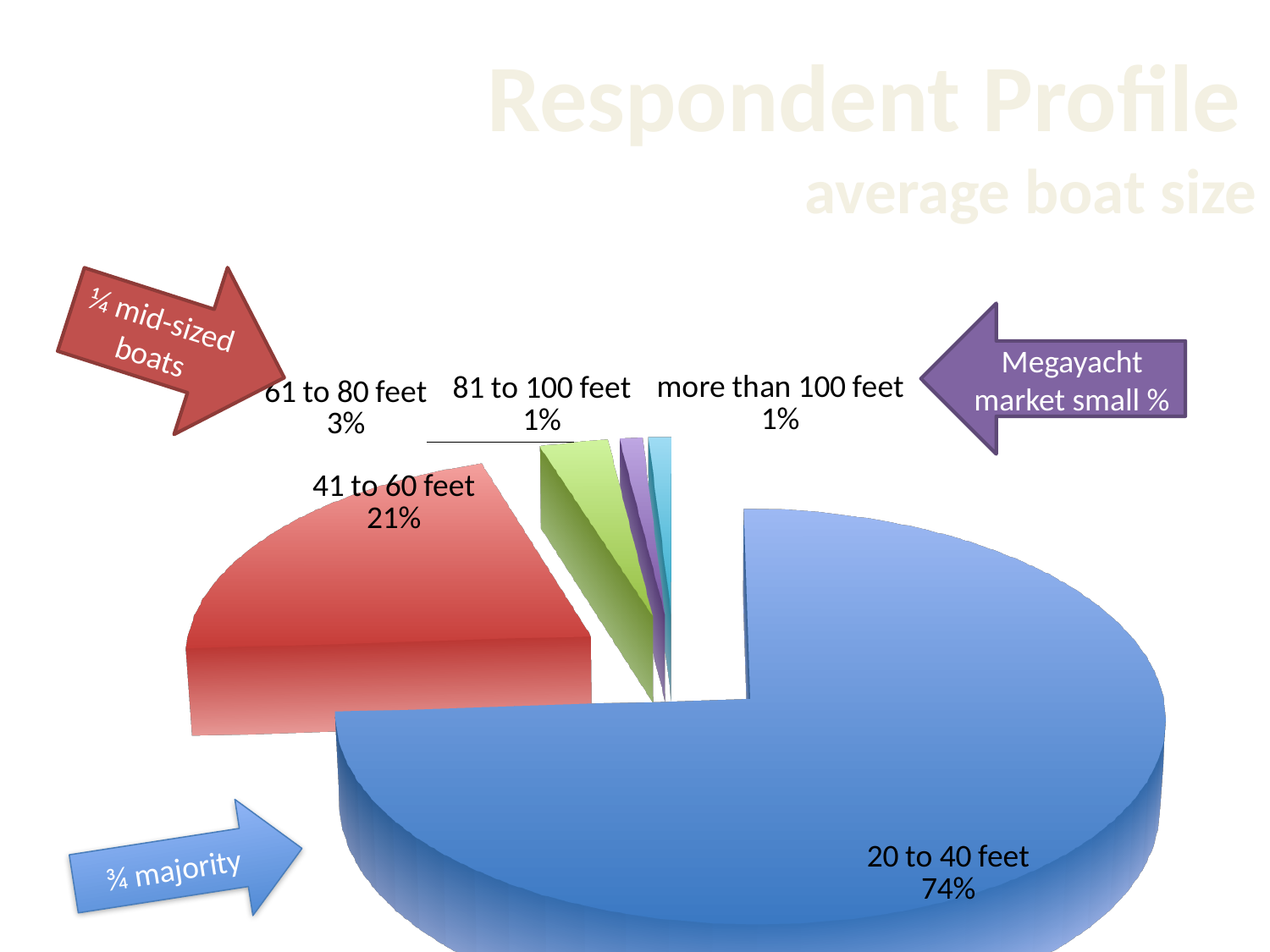
What share of respondents have boats of 61 to 80 feet? 3% What colour is the 20 to 40 feet slice? Blue What is the difference in percentage points between the 20 to 40 feet slice and the 41 to 60 feet slice? 53 What is the subtitle of the slide below 'Respondent Profile'? average boat size Which boat size category has the largest share of the pie? 20 to 40 feet What share of respondents have boats of more than 100 feet? 1% How many boat size categories are shown in the pie chart? 5 What kind of chart is shown on the slide? Pie chart What share of respondents have boats of 20 to 40 feet? 74% What share of respondents have boats of 41 to 60 feet? 21% Which slice is larger: 41 to 60 feet or 61 to 80 feet? 41 to 60 feet What is the combined share of the 81 to 100 feet and more than 100 feet slices? 2%